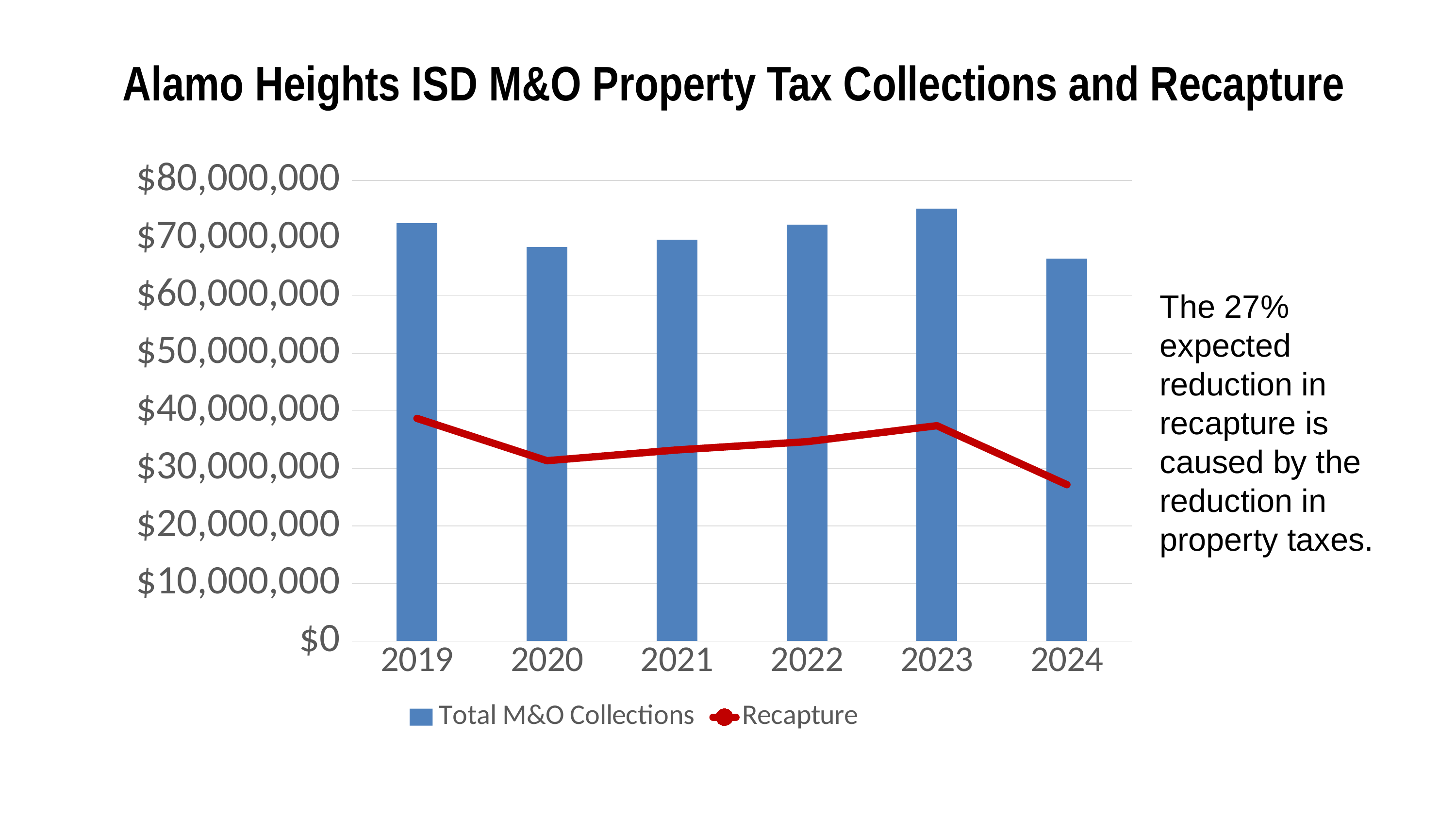
Which year has the lowest Total M&O Collections bar? 2024 Which year has the highest Total M&O Collections bar? 2023 What kind of chart is shown on the slide? A combination bar and line chart Is the Total M&O Collections value for 2023 greater or less than $70,000,000? greater What colour is the Recapture line in the chart? Red How many series does the chart legend list? 2 Is the Recapture value for 2024 greater or less than $30,000,000? less Which year has the lowest Recapture value? 2024 Does the Recapture line rise or fall from 2023 to 2024? fall Is the Total M&O Collections value for 2024 greater or less than $70,000,000? less Which year has the larger Total M&O Collections, 2019 or 2020? 2019 How many years are shown on the x axis of the chart? 6